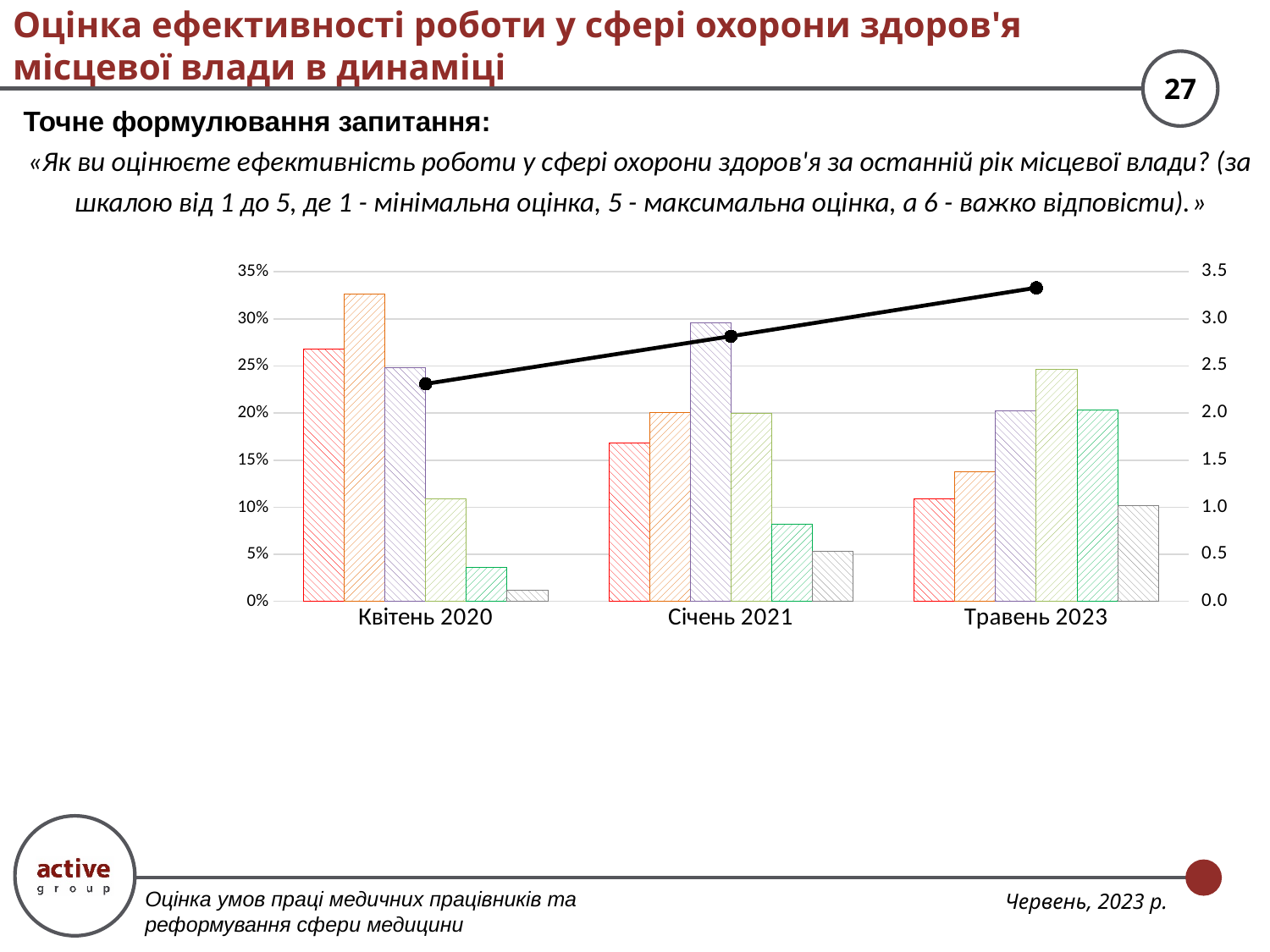
How many bars are plotted in each category group of the chart? 6 Is the tallest bar in the Квітень 2020 group greater or less than 30%? greater What kind of chart is shown on the slide? A bar chart combined with a line Is the line value for Травень 2023 greater or less than 3.0 on the right-hand axis? greater Does the line plotted on the chart rise or fall from Квітень 2020 to Травень 2023? It rises For which category does the line reach its highest value? Травень 2023 For which category does the line have its lowest value? Квітень 2020 Is the line value for Січень 2021 greater or less than 3.0 on the right-hand axis? less How many categories are shown on the x axis of the chart? 3 What are the labels of the three categories on the x axis, from left to right? Квітень 2020, Січень 2021, Травень 2023